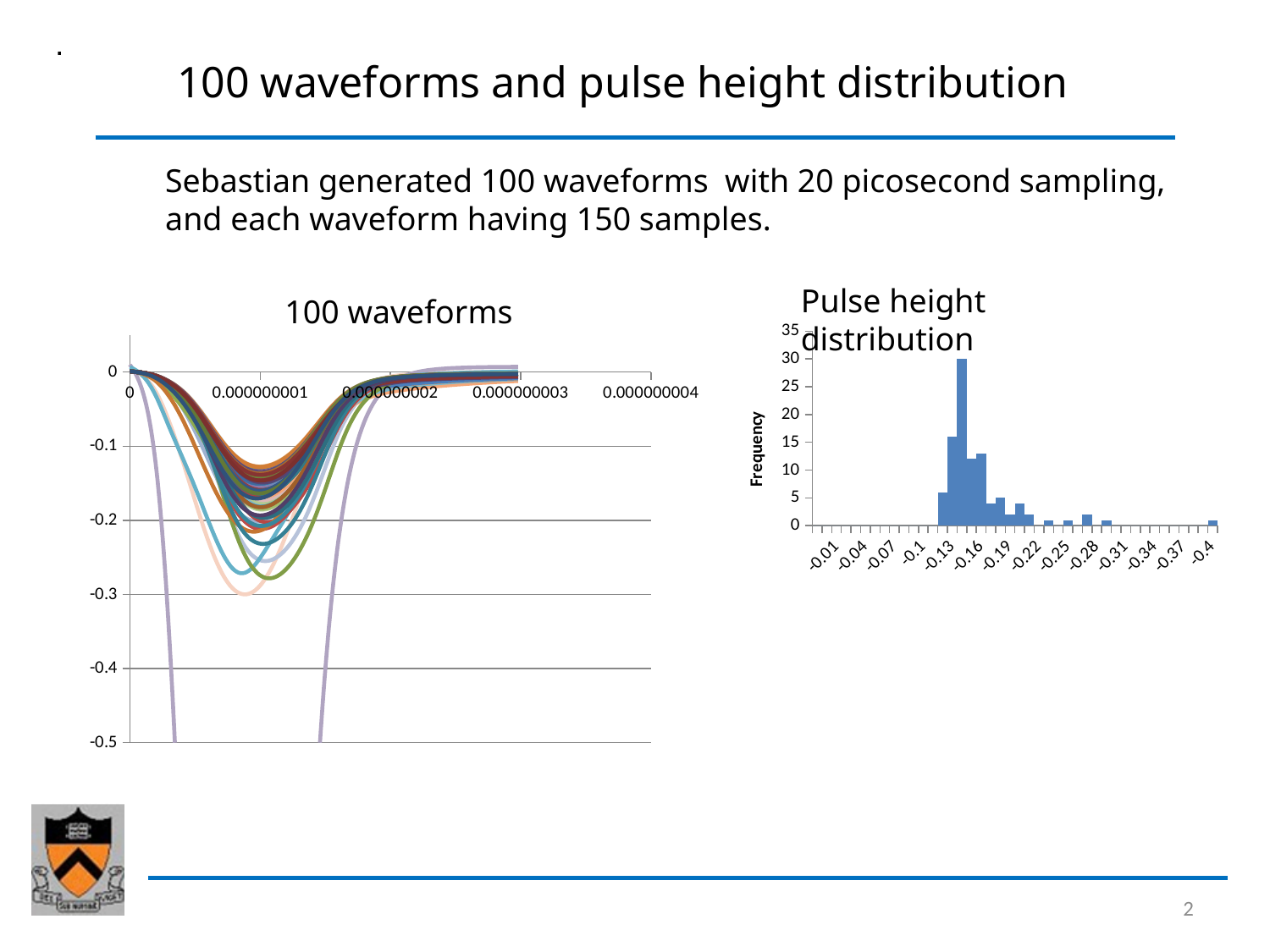
What is the highest value shown on the vertical axis of the 'Pulse height distribution' chart? 35 How many labels are shown on the horizontal axis of the 'Pulse height distribution' chart? 14 In the 'Pulse height distribution' chart, what is the label of the vertical axis? Frequency In the '100 waveforms' chart, do the waveforms dip below zero or rise above zero in the middle of the time range? dip below zero What type of chart is the 'Pulse height distribution' chart? bar chart What type of chart is the '100 waveforms' chart? line chart What is the lowest value shown on the vertical axis of the '100 waveforms' chart? -0.5 In the 'Pulse height distribution' chart, is the frequency of the tallest bar greater or less than 25? greater In the 'Pulse height distribution' chart, is the frequency at -0.16 greater or less than 10? greater In the 'Pulse height distribution' chart, which has the higher frequency, the bar at -0.13 or the bar at -0.31? -0.13 In the 'Pulse height distribution' chart, is the frequency at -0.4 greater or less than 5? less In the 'Pulse height distribution' chart, which has the higher frequency, the bar at -0.16 or the bar at -0.4? -0.16